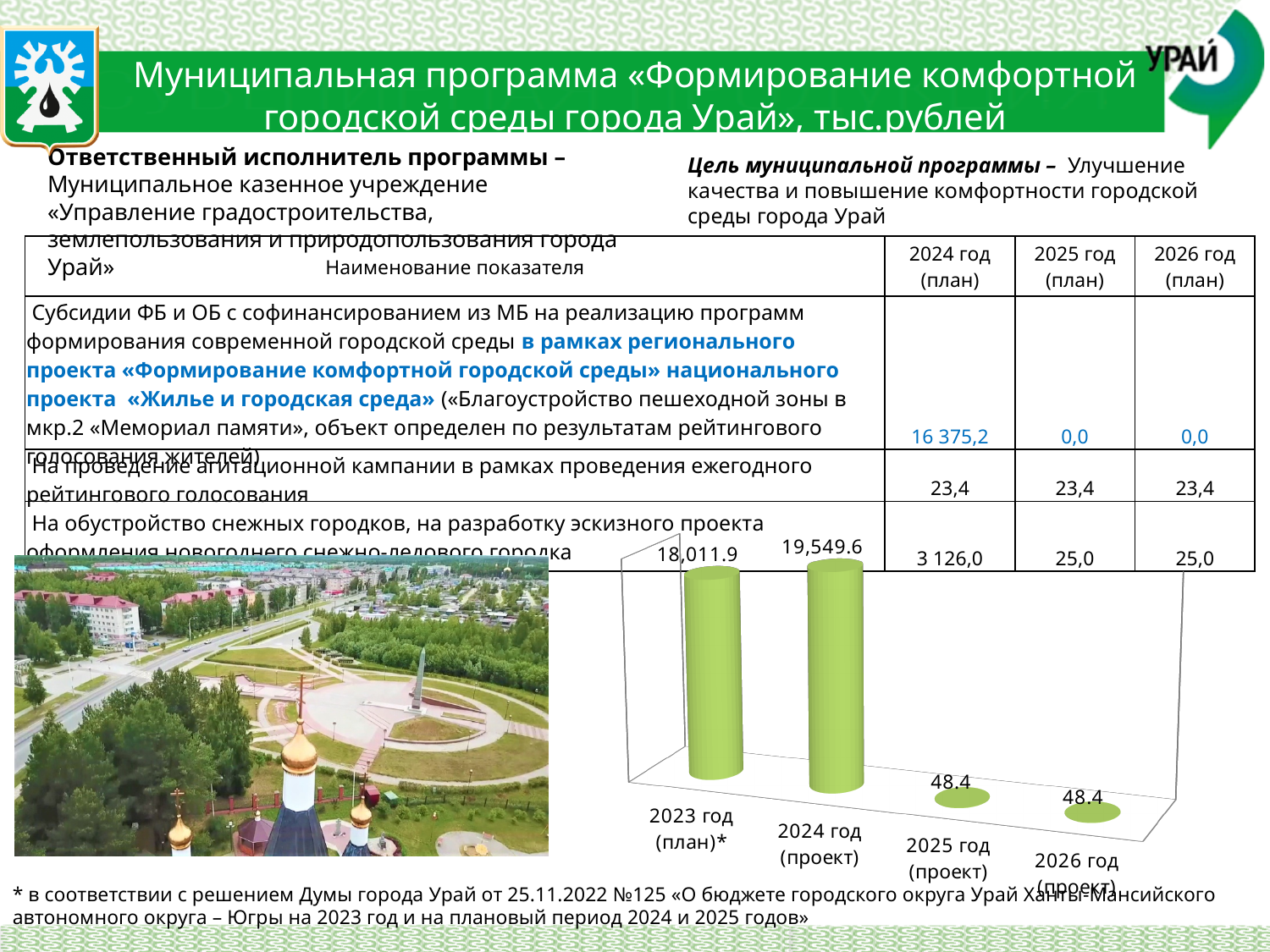
Which is larger in the bar chart: the value for 2023 год (план)* or the value for 2025 год (проект)? 2023 год (план)* What is the difference between the values for 2024 год (проект) and 2023 год (план)* in the bar chart? 1,537.7 What is the difference between the values for 2024 год (проект) and 2026 год (проект) in the bar chart? 19,501.2 Do the values in the bar chart rise or fall from 2024 год (проект) to 2025 год (проект)? Fall What kind of chart is shown on the slide? Bar chart What is the value for 2023 год (план)* in the bar chart? 18,011.9 What is the value for 2026 год (проект) in the bar chart? 48.4 What colour are the bars in the chart? Green What is the value for 2024 год (проект) in the bar chart? 19,549.6 What is the value for 2025 год (проект) in the bar chart? 48.4 Which category has the highest value in the bar chart? 2024 год (проект) How many categories are shown in the bar chart? 4